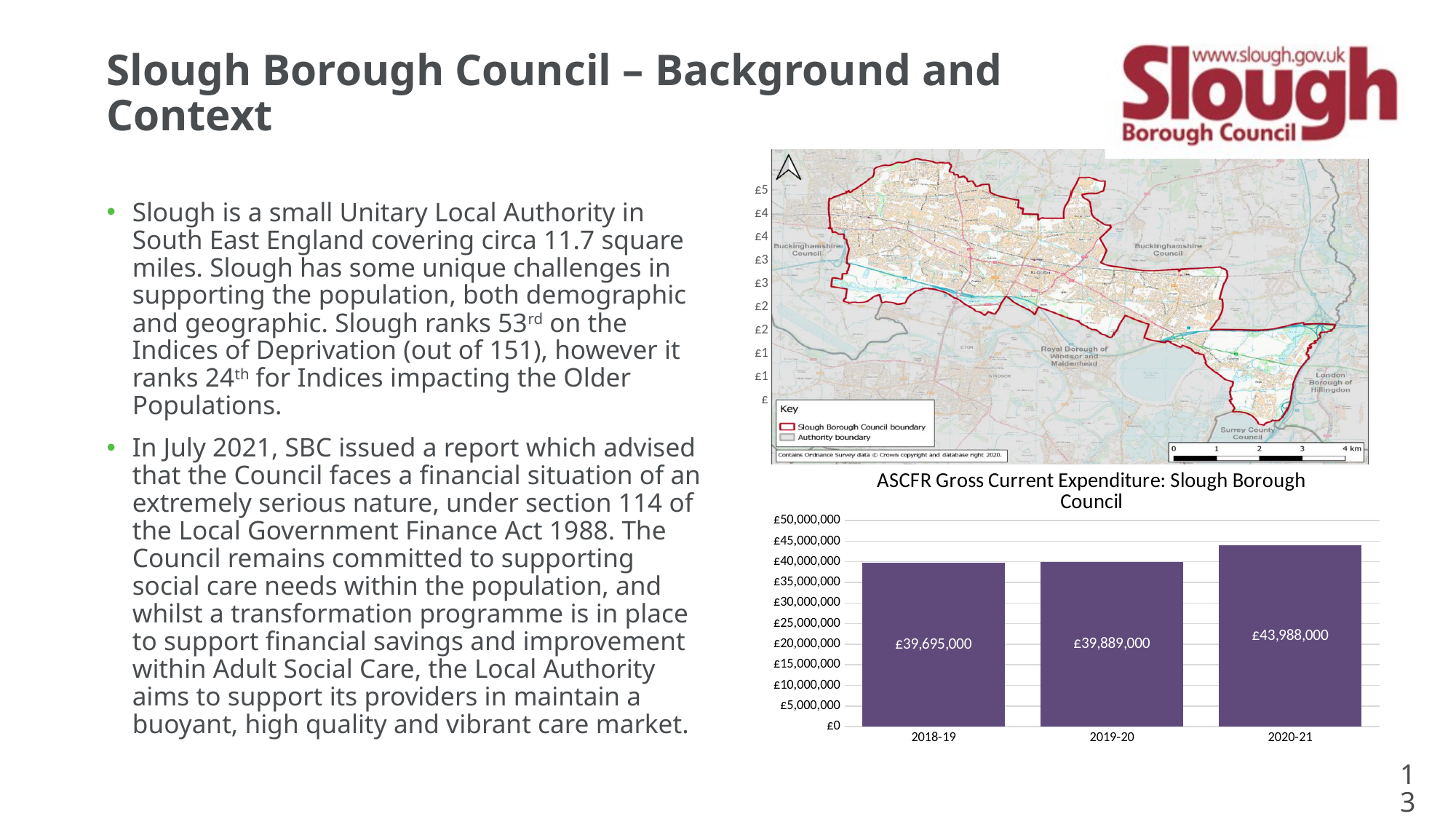
Which year has the highest ASCFR Gross Current Expenditure? 2020-21 What kind of chart is used to show ASCFR Gross Current Expenditure? bar chart Is the ASCFR Gross Current Expenditure for 2020-21 greater or less than £40,000,000? greater What is the difference in ASCFR Gross Current Expenditure between 2020-21 and 2019-20? £4,099,000 What is the ASCFR Gross Current Expenditure for 2018-19? £39,695,000 Which year has the larger ASCFR Gross Current Expenditure, 2018-19 or 2020-21? 2020-21 What is the ASCFR Gross Current Expenditure for 2019-20? £39,889,000 How many years are shown in the ASCFR Gross Current Expenditure chart? 3 What is the difference in ASCFR Gross Current Expenditure between 2020-21 and 2018-19? £4,293,000 What is the ASCFR Gross Current Expenditure for 2020-21? £43,988,000 Which year has the lowest ASCFR Gross Current Expenditure? 2018-19 Does ASCFR Gross Current Expenditure rise or fall from 2018-19 to 2020-21? rise